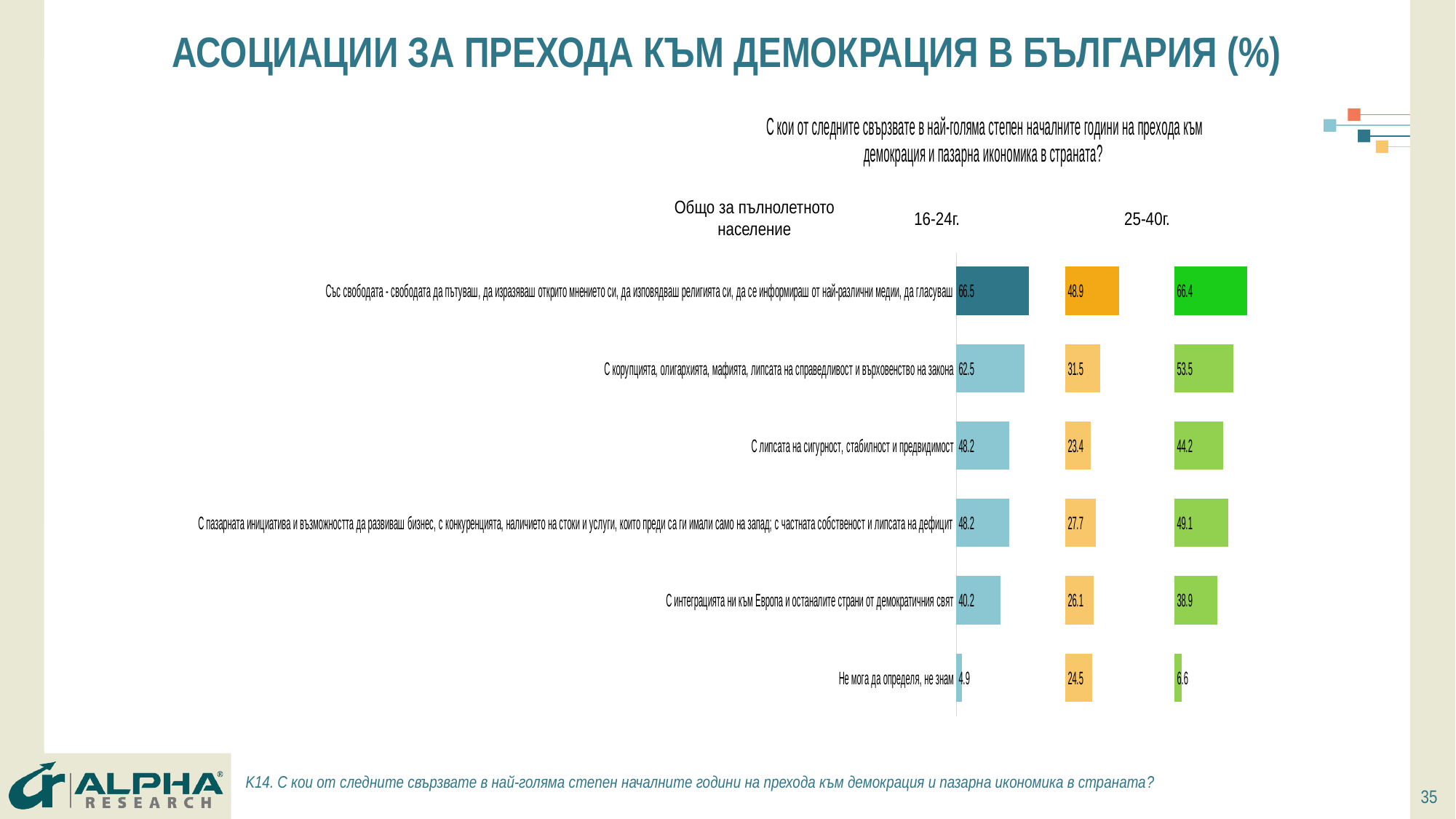
In the '25-40г.' chart, what is the value for 'С интеграцията ни към Европа и останалите страни от демократичния свят'? 38.9 In the 'Общо за пълнолетното население' chart, what is the value for 'Със свободата - свободата да пътуваш...'? 66.5 How many categories are shown in each chart? 6 In the '16-24г.' chart, what is the value for 'С корупцията, олигархията, мафията, липсата на справедливост и върховенство на закона'? 31.5 In the '25-40г.' chart, which category has the lowest value? Не мога да определя, не знам What is the difference between the '25-40г.' value and the '16-24г.' value for 'С корупцията, олигархията, мафията, липсата на справедливост и върховенство на закона'? 22.0 What is the difference between the 'Общо за пълнолетното население' value and the '16-24г.' value for 'С липсата на сигурност, стабилност и предвидимост'? 24.8 For 'Не мога да определя, не знам', which is larger: the '16-24г.' value or the '25-40г.' value? 16-24г. How many age-group columns (charts) are shown on the slide? 3 What kind of chart is used on this slide? Bar chart In the '16-24г.' chart, what is the value for 'С пазарната инициатива и възможността да развиваш бизнес...'? 27.7 In the '16-24г.' chart, which category has the highest value? Със свободата - свободата да пътуваш, да изразяваш открито мнението си, да изповядваш религията си, да се информираш от най-различни медии, да гласуваш